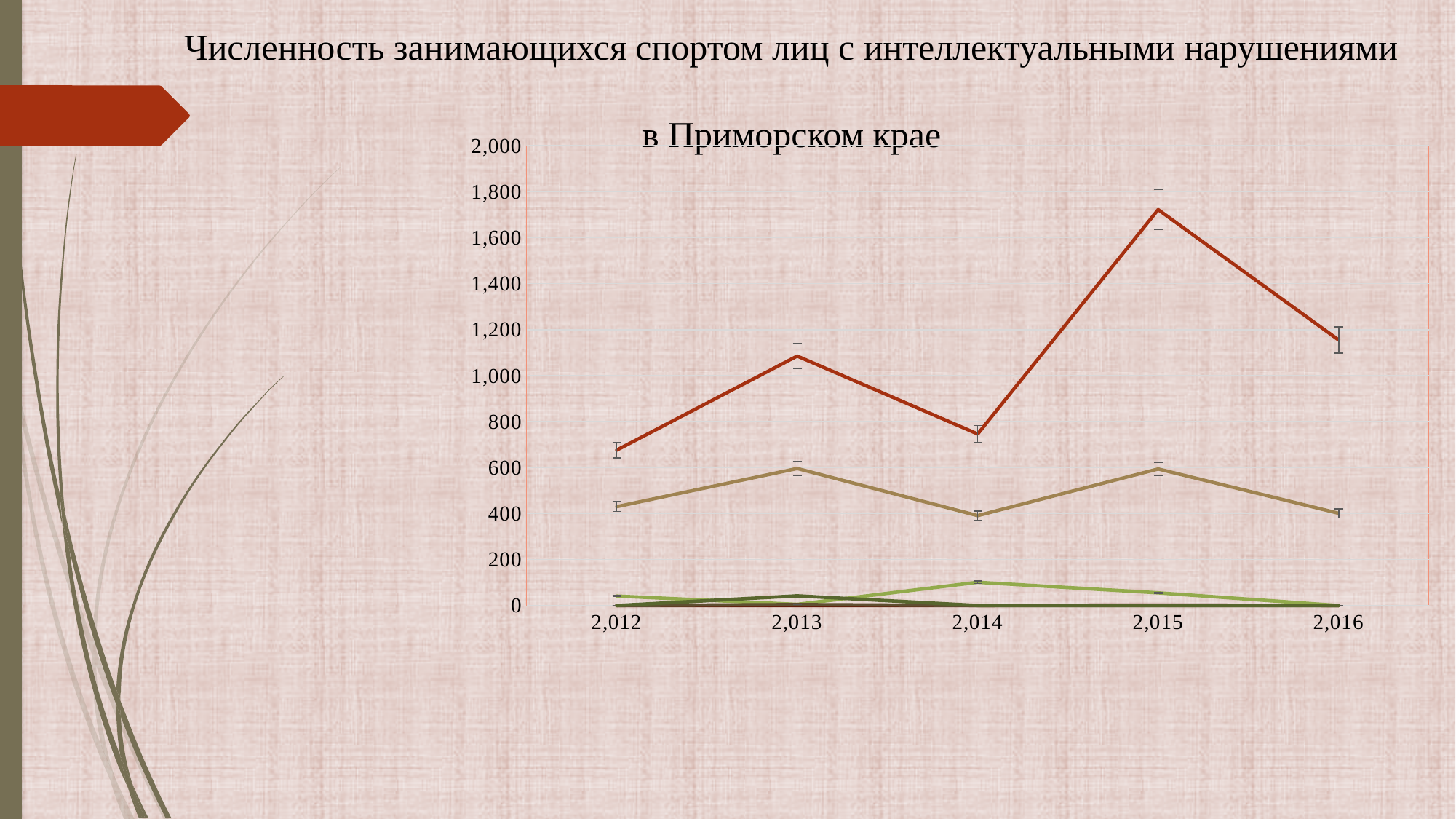
What kind of chart is shown on the slide? line chart Is the value of the tan (light brown) line in 2,012 greater or less than 600? less In which year does the red line have its lowest value? 2,012 What is the title of the chart? Численность занимающихся спортом лиц с интеллектуальными нарушениями в Приморском крае Is the value of the red line in 2,014 greater or less than 800? less What is the highest value shown on the y axis? 2,000 Is the value of the red line in 2,015 greater or less than 1,600? greater In which year does the red line reach its highest value? 2,015 Which line has the larger value in 2,015, the red line or the tan (light brown) line? the red line How many years are shown along the x axis? 5 Does the red line rise or fall from 2,015 to 2,016? fall